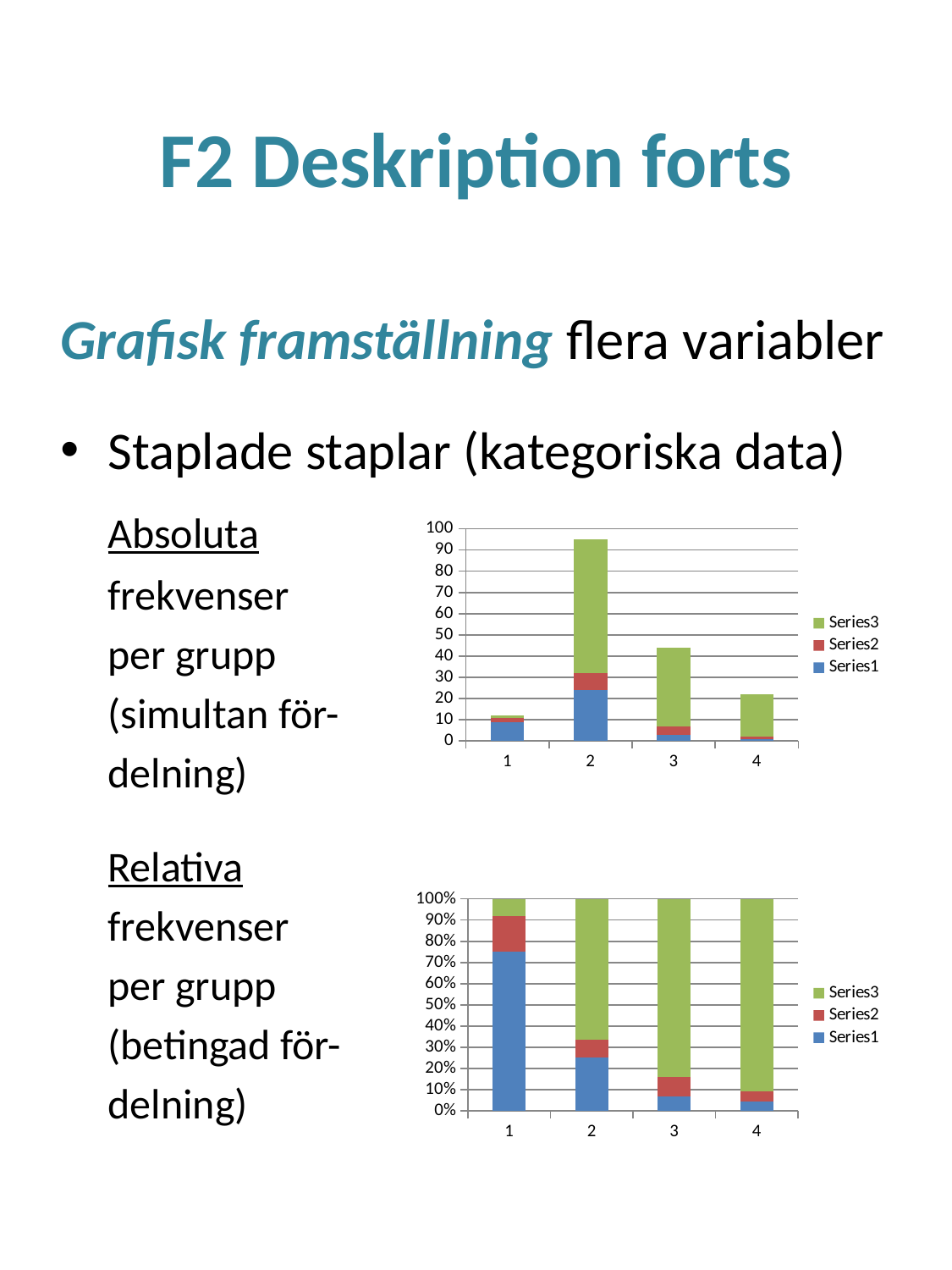
How many series does the legend of the top chart list? 3 In the bottom chart, is the Series1 share for category 1 greater or less than 50%? greater In the top chart, is the total for category 2 greater or less than 80? greater In the top chart, which category has the shortest stacked bar? 1 In the top chart, is the total for category 4 greater or less than 30? less How many categories are shown on the x axis of the top chart? 4 In the top chart, which category has the tallest stacked bar? 2 In the top chart, which stacked bar is taller, category 1 or category 3? 3 In the bottom chart, does the Series1 share rise or fall from category 1 to category 4? fall Which series is shown in green in the legend of the bottom chart? Series3 What kind of chart is the top chart (absolute frequencies)? stacked bar chart What kind of chart is the bottom chart (relative frequencies)? 100% stacked bar chart